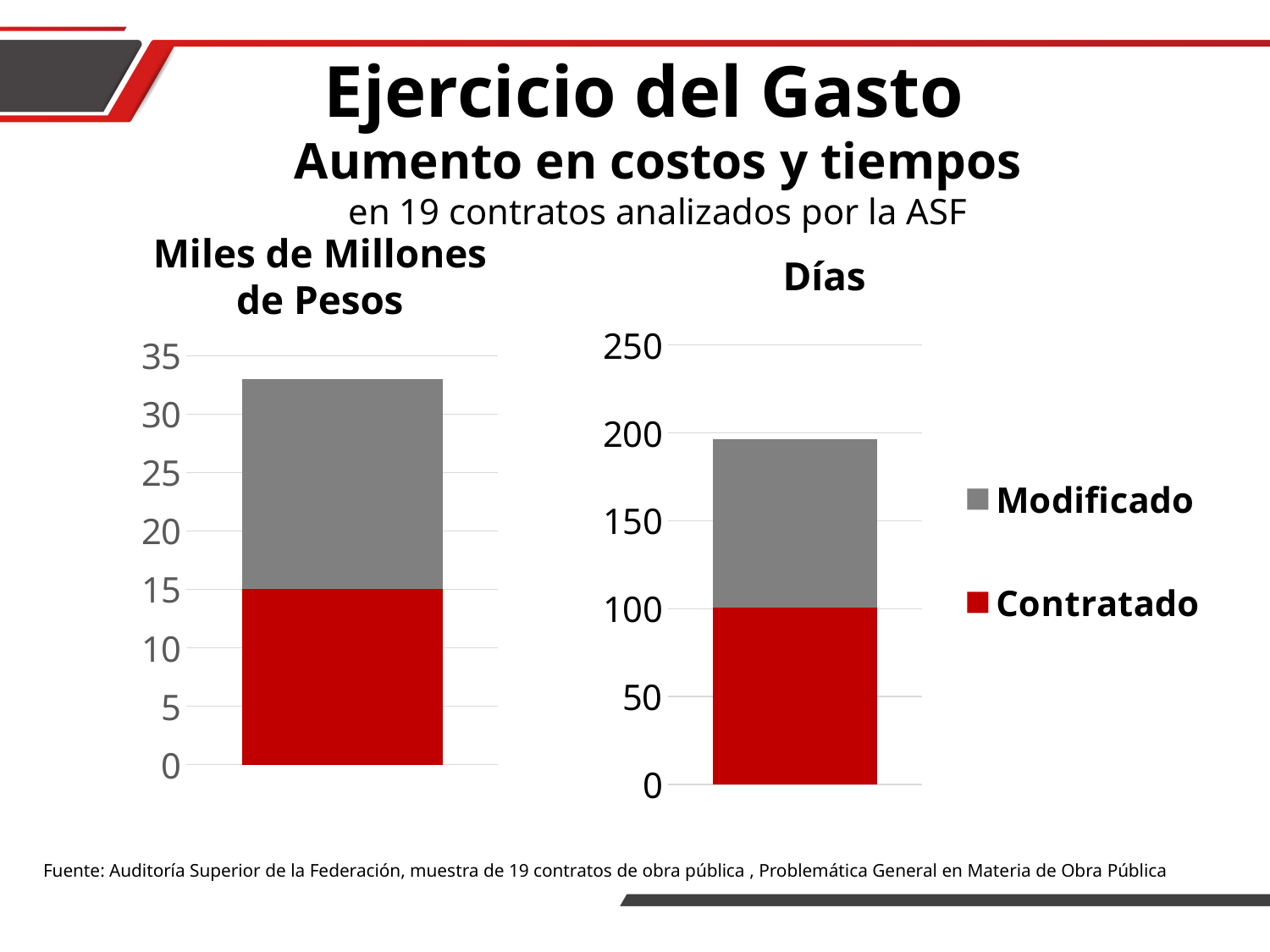
How many stacked bars are plotted in the 'Días' chart? 1 In the 'Miles de Millones de Pesos' chart, is the Contratado segment greater or less than 10? greater In the 'Miles de Millones de Pesos' chart, is the total height of the stacked bar greater or less than 35? less How many series does the legend list? 2 What are the two series named in the legend? Modificado and Contratado In the 'Miles de Millones de Pesos' chart, what is the value of the Contratado segment? 15 In the 'Días' chart, is the total height of the stacked bar greater or less than 150? greater Which colour represents the Contratado series? Red What kind of chart is the 'Miles de Millones de Pesos' chart? Bar chart